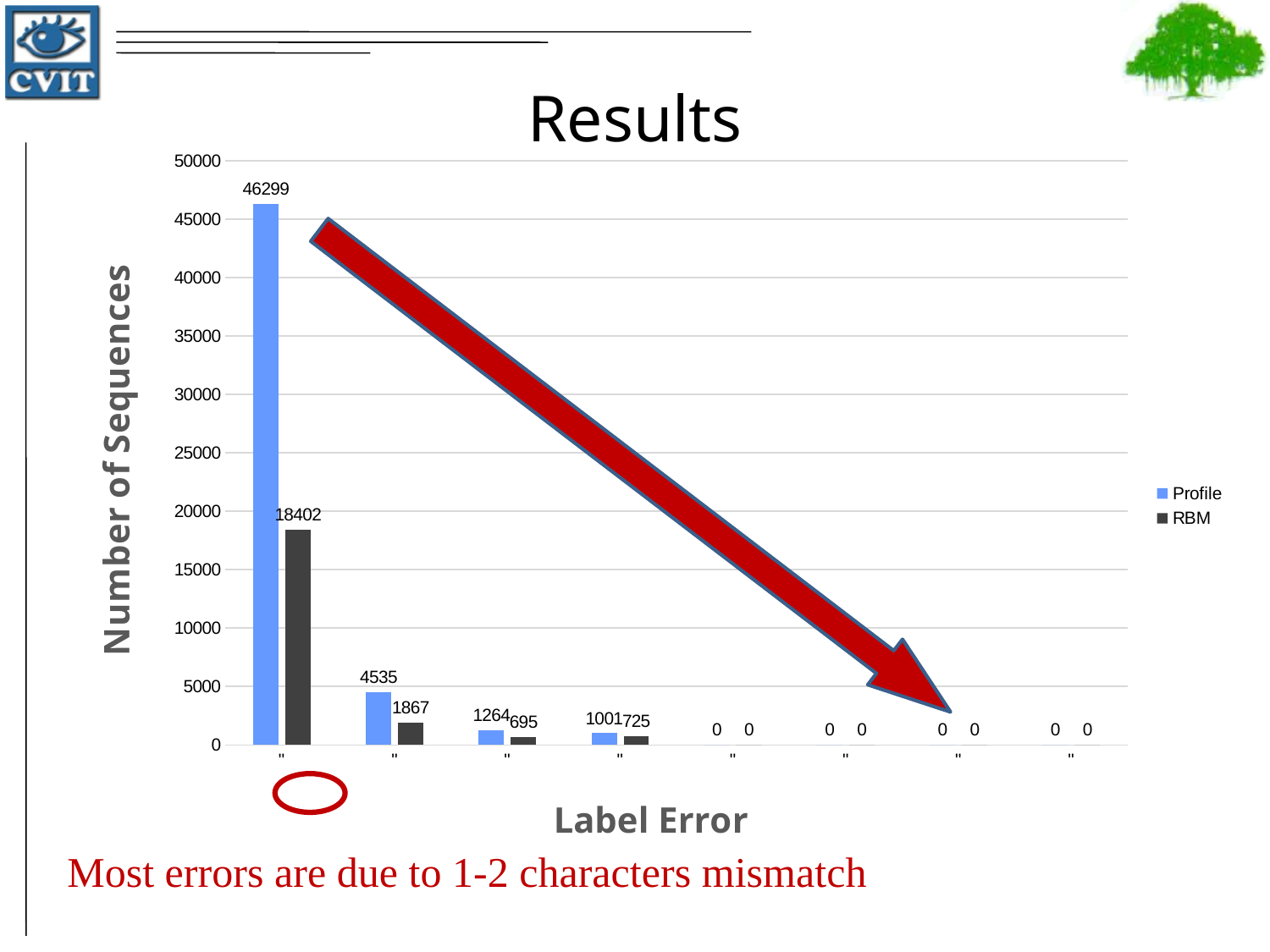
What is the RBM value for the third category group from the left? 695 What is the Profile value for the leftmost category group? 46299 What is the difference between the Profile and RBM values in the leftmost category group? 27897 How many series does the legend list? 2 What is the Profile value for the second category group from the left? 4535 How many category groups are shown along the x axis? 8 What type of chart is shown on the slide? bar chart Which series has the highest value anywhere on the chart? Profile What is the RBM value for the leftmost category group? 18402 What are the names of the two series in the legend? Profile and RBM What is the label of the y axis? Number of Sequences In the fourth category group from the left, which series has the larger value, Profile or RBM? Profile